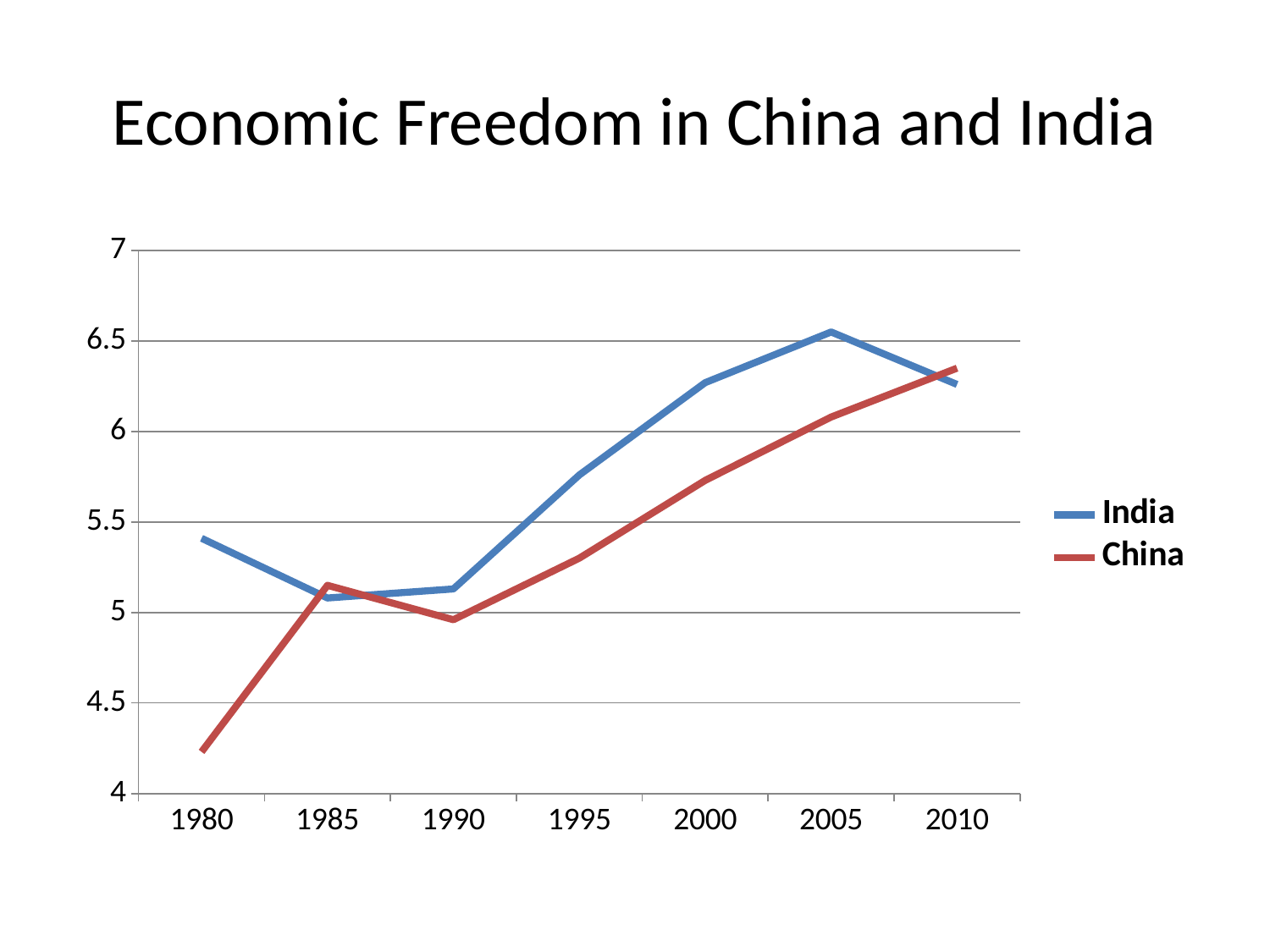
Does the China series generally rise or fall from 1980 to 2010? rise In 1980, which series has the larger value, India or China? India Is the value for China in 1980 greater or less than 4.5? less Is the value for India in 2005 greater or less than 6.5? greater In which year does the India series reach its highest value? 2005 In which year does the India series have its lowest value? 1985 What colour is the line for China? red What kind of chart is shown on the slide? line chart In 2000, which series has the larger value, India or China? India How many years are plotted along the x axis? 7 In which year does the China series have its lowest value? 1980 How many series does the legend list? 2